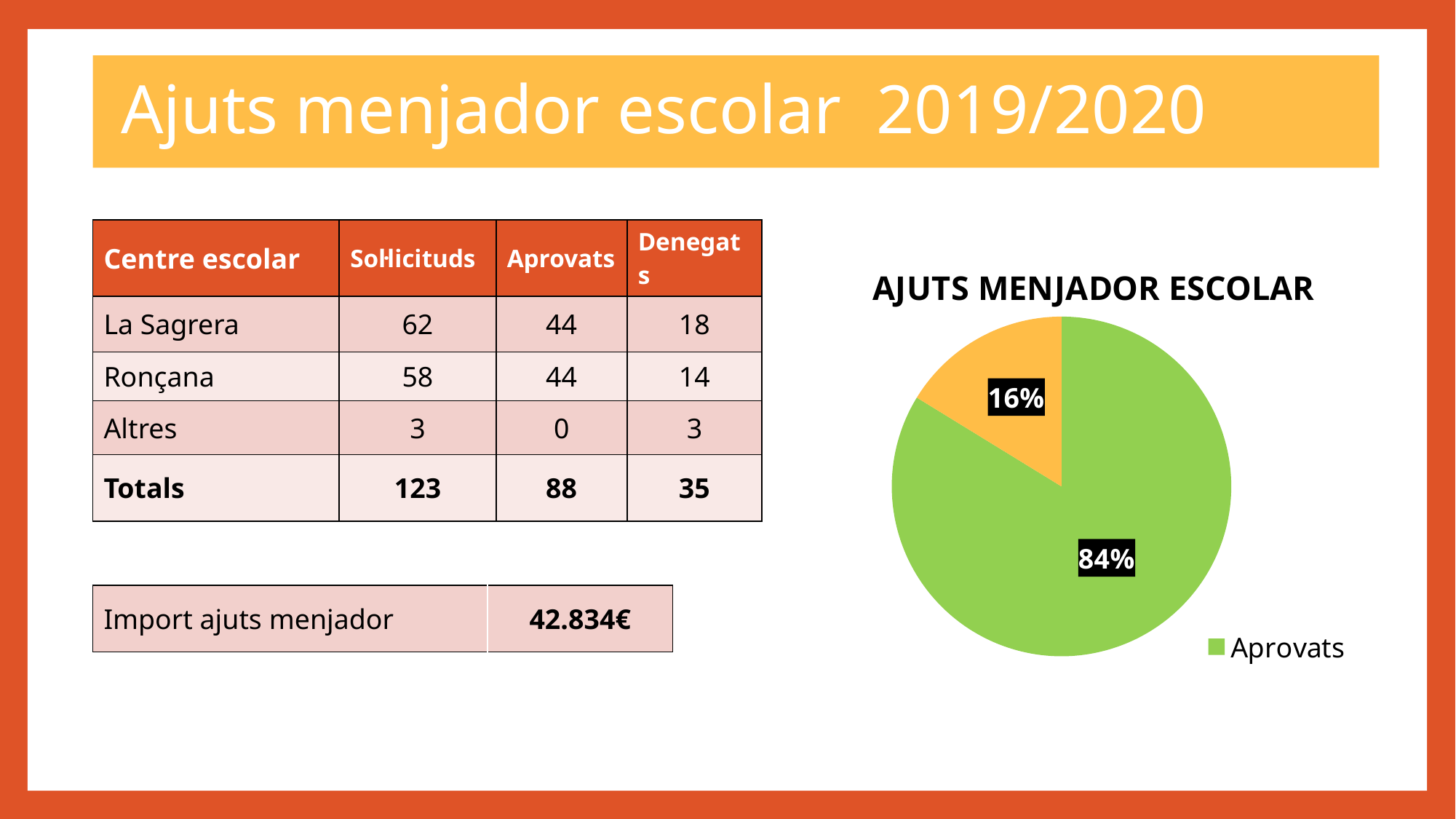
What is the title of the chart? AJUTS MENJADOR ESCOLAR What is the difference in percentage points between the green slice and the orange slice? 68 What share of the pie does Aprovats represent? 84% Which slice of the pie is the largest? Aprovats What colour is the Aprovats slice in the pie chart? green How many entries does the chart legend list? 1 How many slices does the pie chart have? 2 What type of chart is shown on the slide? pie chart What percentage is shown on the orange slice of the pie? 16% Which is larger, the green slice or the orange slice? the green slice Is the share for Aprovats greater or less than 50%? greater